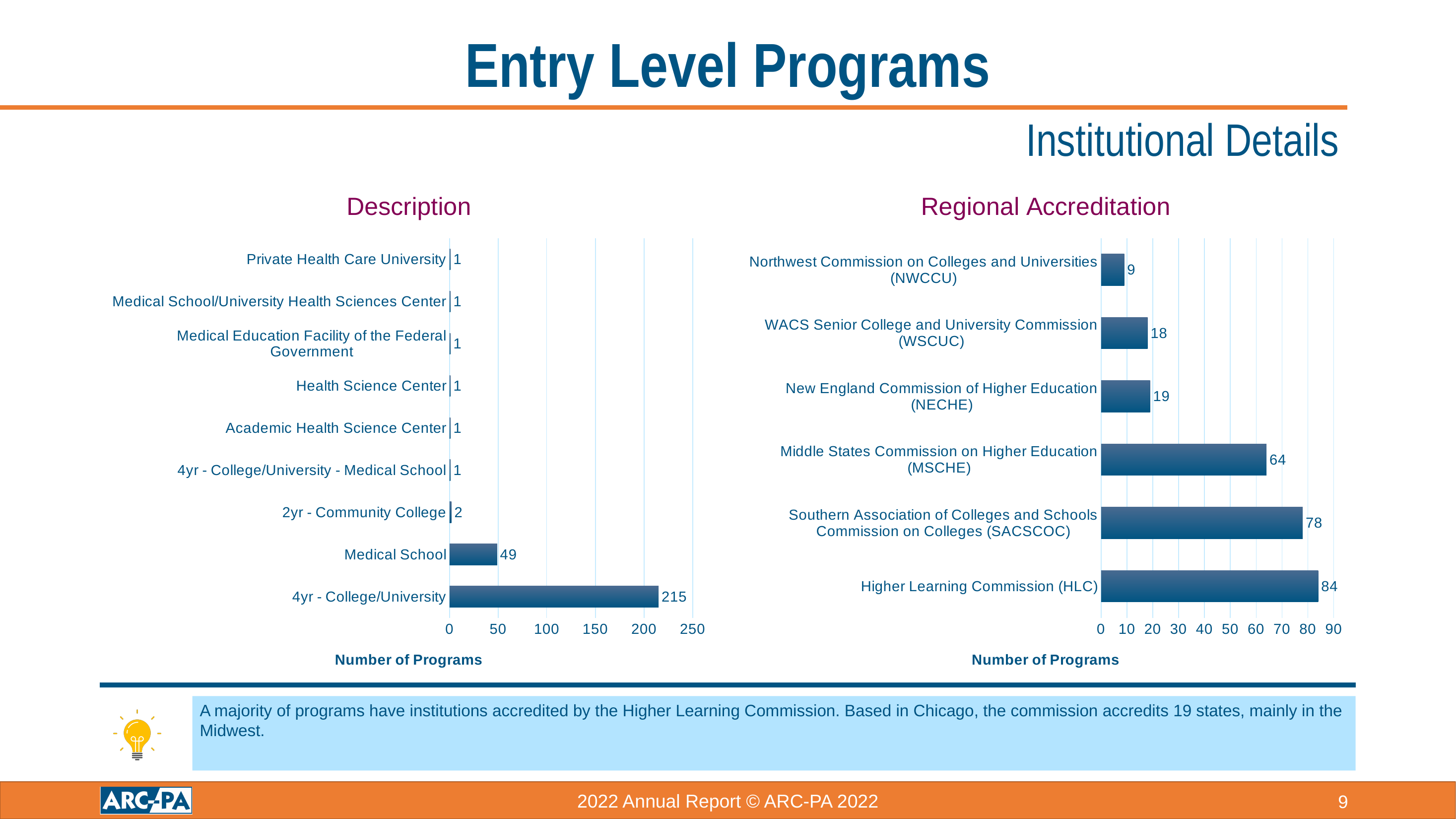
In the Description chart, how many categories are shown? 9 In the Regional Accreditation chart, what is the difference between SACSCOC and MSCHE? 14 In the Description chart, how many programs are at a 4yr - College/University? 215 In the Regional Accreditation chart, which accreditor has the lowest number of programs? Northwest Commission on Colleges and Universities (NWCCU) In the Regional Accreditation chart, which is larger: WSCUC or NWCCU? WSCUC In the Description chart, what is the difference between 4yr - College/University and Medical School? 166 In the Description chart, which category has the highest number of programs? 4yr - College/University In the Description chart, what is the value for 2yr - Community College? 2 In the Regional Accreditation chart, how many programs are accredited by the Higher Learning Commission (HLC)? 84 What type of chart is the Regional Accreditation chart? Bar chart In the Description chart, what is the value for Medical School? 49 In the Regional Accreditation chart, how many accreditors are listed? 6